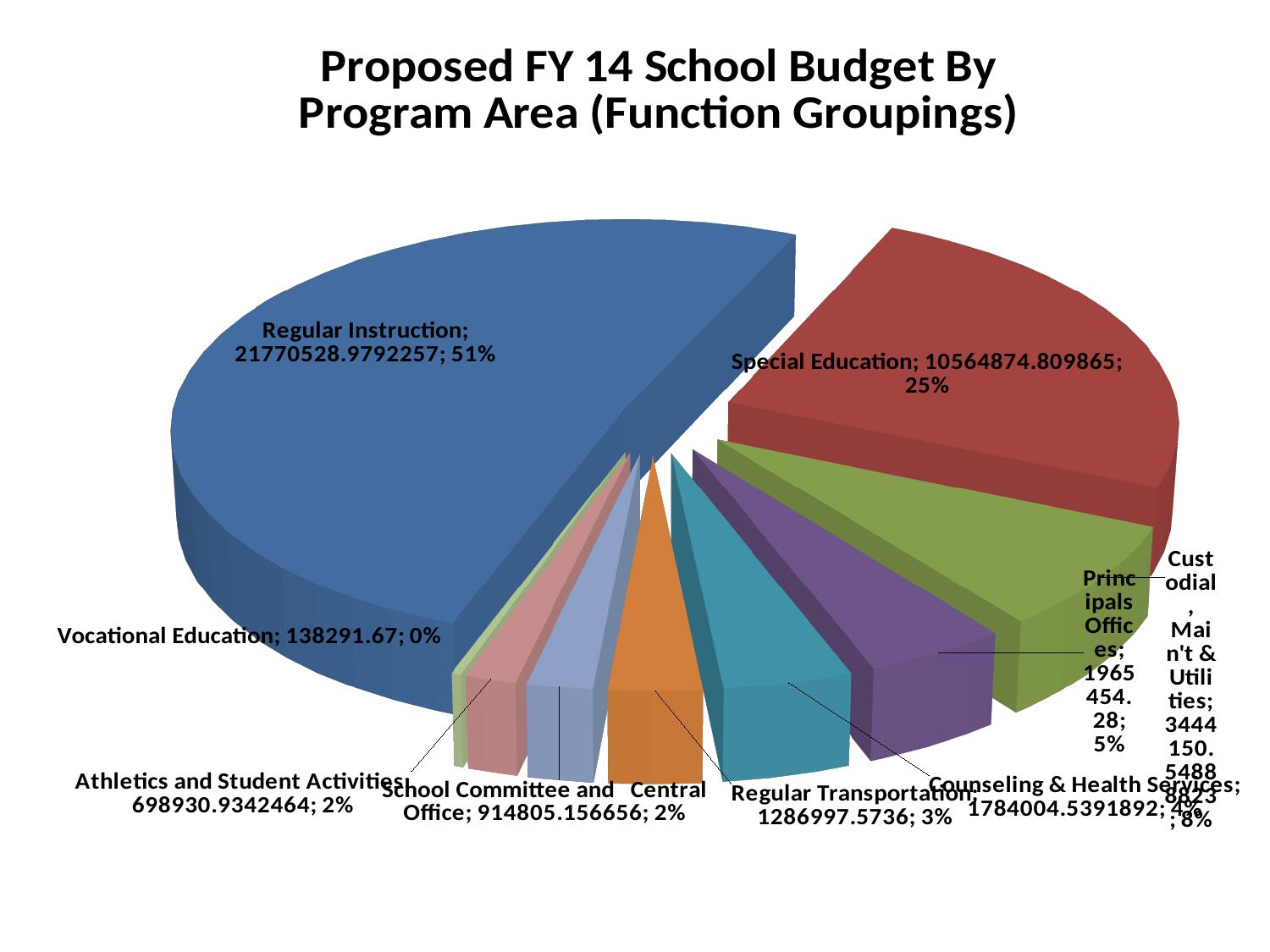
What is the value shown for Vocational Education? 138291.67 What share of the pie does Regular Instruction represent? 51% Which program area has the smallest slice of the pie? Vocational Education What share of the pie does Special Education represent? 25% What kind of chart is shown on the slide? pie chart What is the value shown for Special Education? 10564874.809865 What is the title of the chart? Proposed FY 14 School Budget By Program Area (Function Groupings) What is the value shown for Regular Instruction? 21770528.9792257 How many slices does the pie chart have? 9 Which is larger, the value for Counseling & Health Services or the value for Regular Transportation? Counseling & Health Services Which program area has the largest slice of the pie? Regular Instruction What is the value shown for Regular Transportation? 1286997.5736